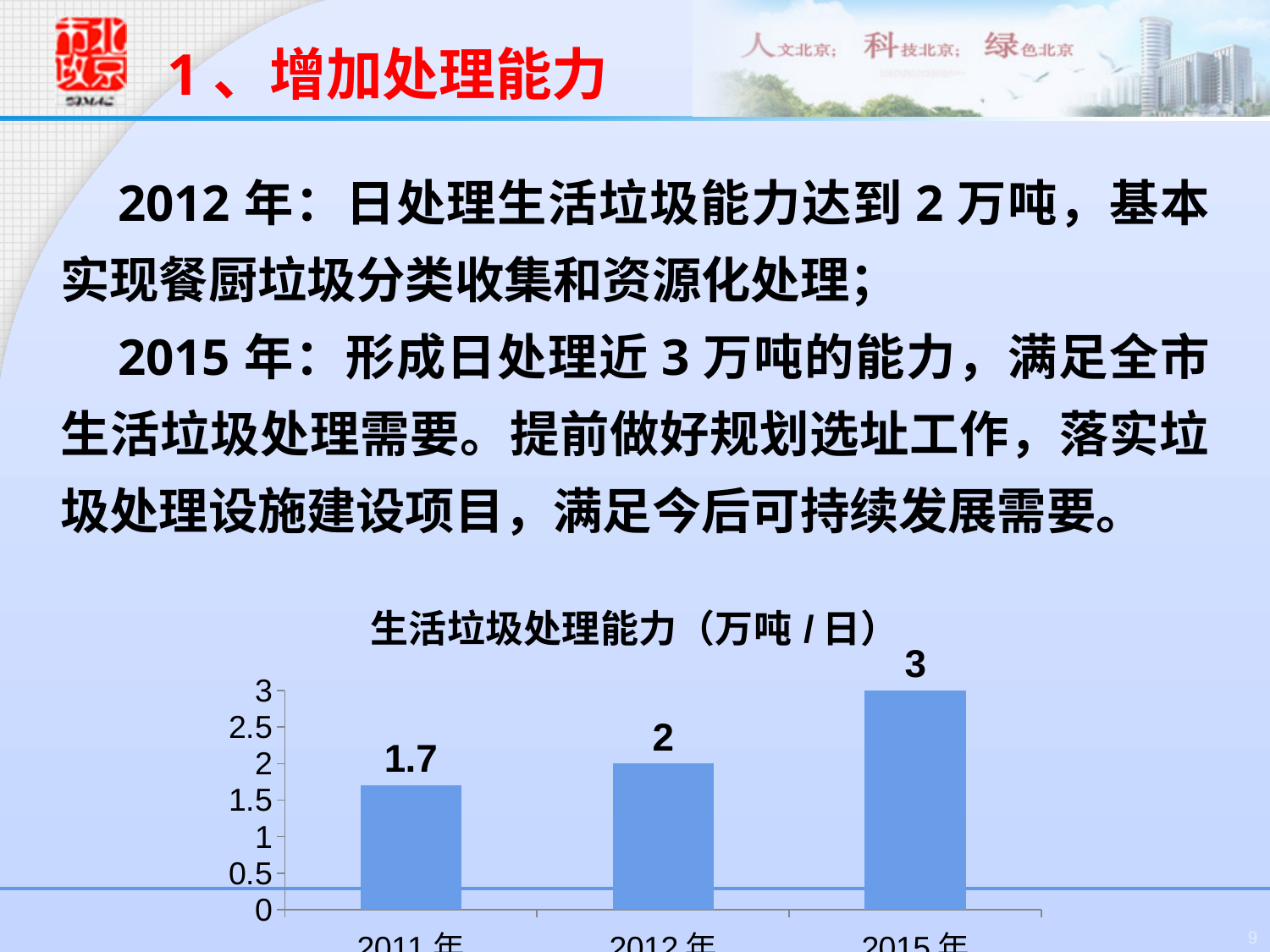
What kind of chart is shown on the slide? bar chart What is the value for 2011年 in the chart? 1.7 Which year has the highest value in the chart? 2015年 Do the values rise or fall from 2011年 to 2015年? rise What is the difference between the values for 2012年 and 2011年? 0.3 How many bars are shown in the chart? 3 What is the value for 2015年 in the chart? 3 Is the value for 2011年 greater or less than 1.5? greater Which is larger, the value for 2012年 or the value for 2015年? 2015年 Which year has the lowest value in the chart? 2011年 What is the value for 2012年 in the chart? 2 What is the difference between the values for 2015年 and 2011年? 1.3